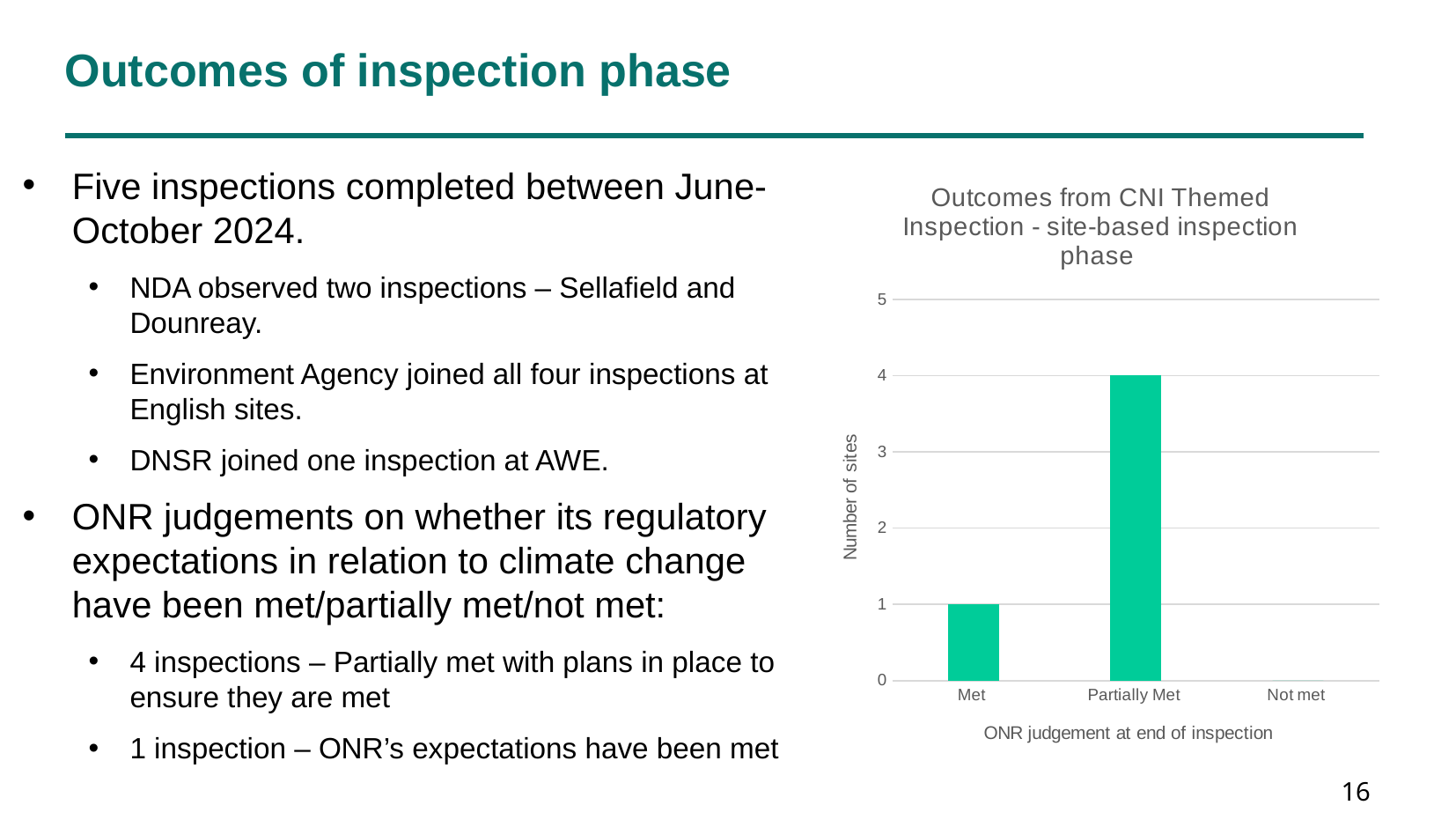
Which has more sites, Met or Partially Met? Partially Met What is the number of sites for Partially Met? 4 How many categories are shown on the x axis of the chart? 3 Which category has the lowest number of sites? Not met What is the total number of sites across Met and Partially Met? 5 What is the difference in number of sites between Partially Met and Met? 3 What is the title of the chart? Outcomes from CNI Themed Inspection - site-based inspection phase Which category has the highest number of sites? Partially Met Is the value for Partially Met greater or less than 3? greater What type of chart is shown on the slide? bar chart What is the label of the y axis? Number of sites What is the number of sites for Met? 1